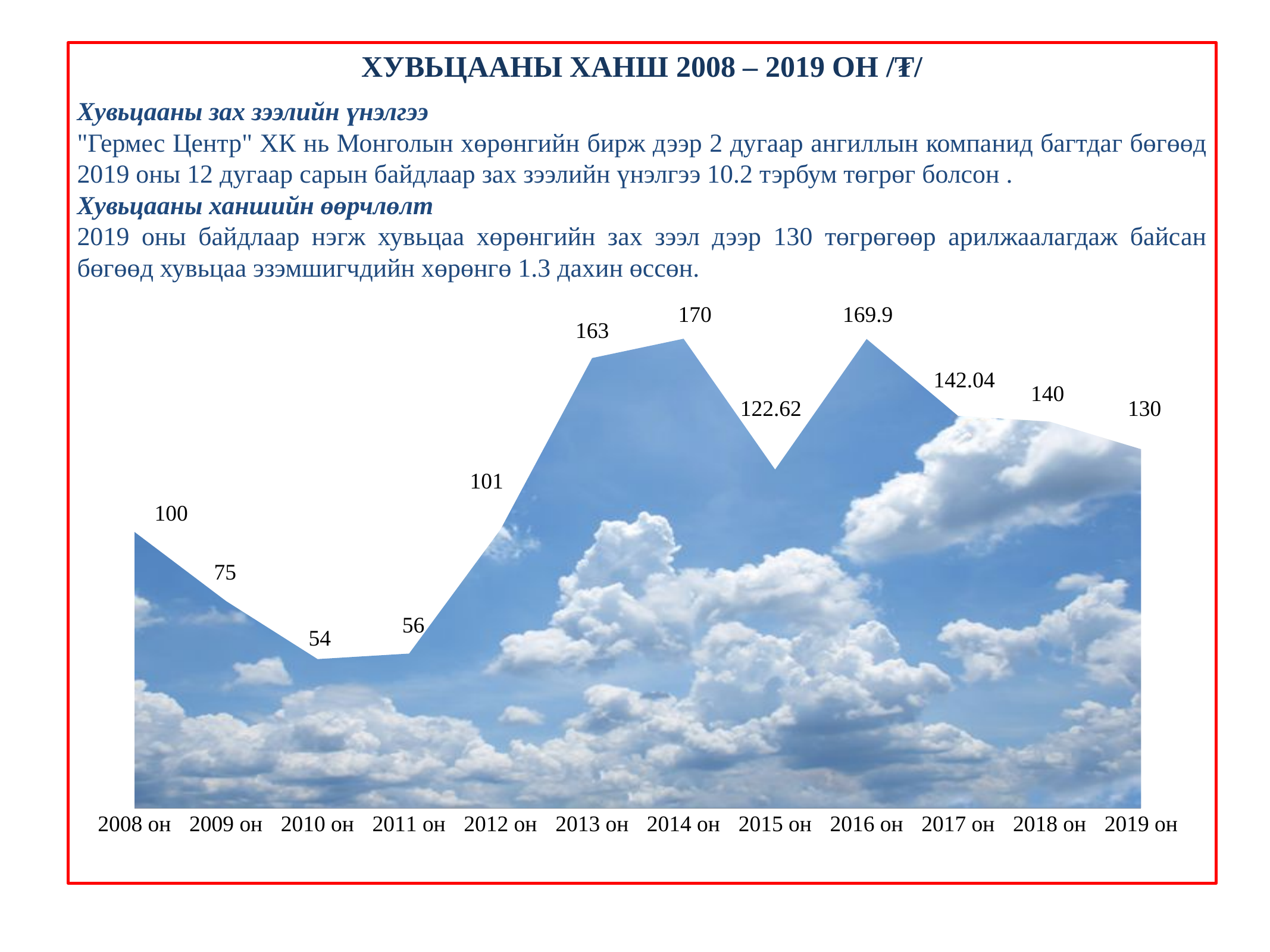
What is the value for 2015 он? 122.62 What is the value for 2017 он? 142.04 What is the difference between the values for 2014 он and 2008 он? 70 Which year has the highest value? 2014 он Do the values rise or fall from 2008 он to 2010 он? Fall What is the value for 2008 он? 100 How many years are plotted on the chart? 12 What is the value for 2019 он? 130 Which is larger, the value for 2013 он or the value for 2017 он? 2013 он Which year has the lowest value? 2010 он What is the difference between the values for 2018 он and 2019 он? 10 What kind of chart is shown on the slide? Area chart